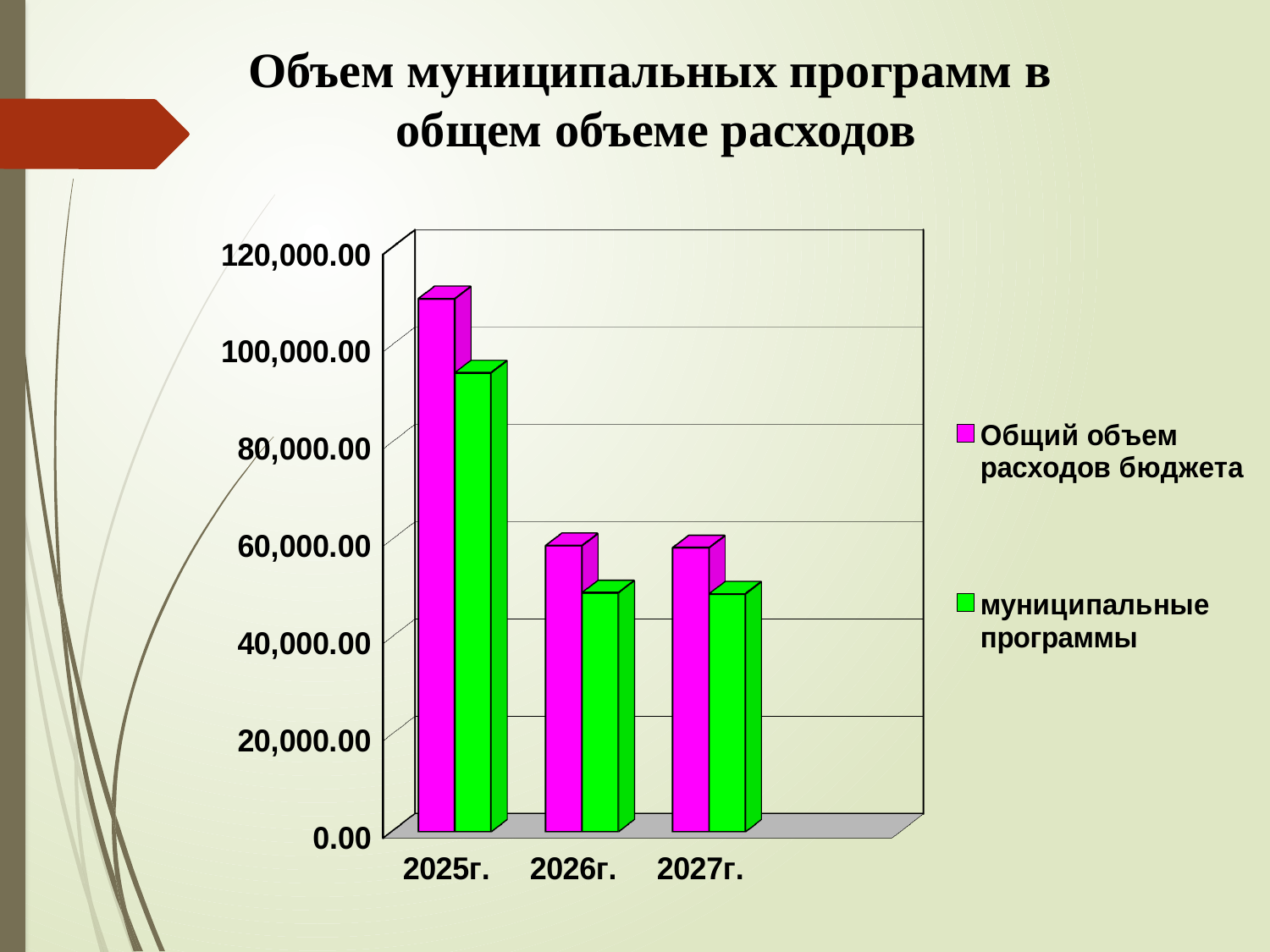
Which year has the highest value for Общий объем расходов бюджета? 2025г. Do the values for Общий объем расходов бюджета rise or fall from 2025г. to 2027г.? fall Which colour represents муниципальные программы in the legend? green How many year categories are shown on the x axis? 3 Which year has the highest value for муниципальные программы? 2025г. Is the value for Общий объем расходов бюджета in 2025г. greater or less than 100,000.00? greater Is the value for муниципальные программы in 2027г. greater or less than 40,000.00? greater How many series does the legend list? 2 In 2025г., which is larger: Общий объем расходов бюджета or муниципальные программы? Общий объем расходов бюджета Is the value for муниципальные программы in 2025г. greater or less than 100,000.00? less What kind of chart is shown on the slide? bar chart